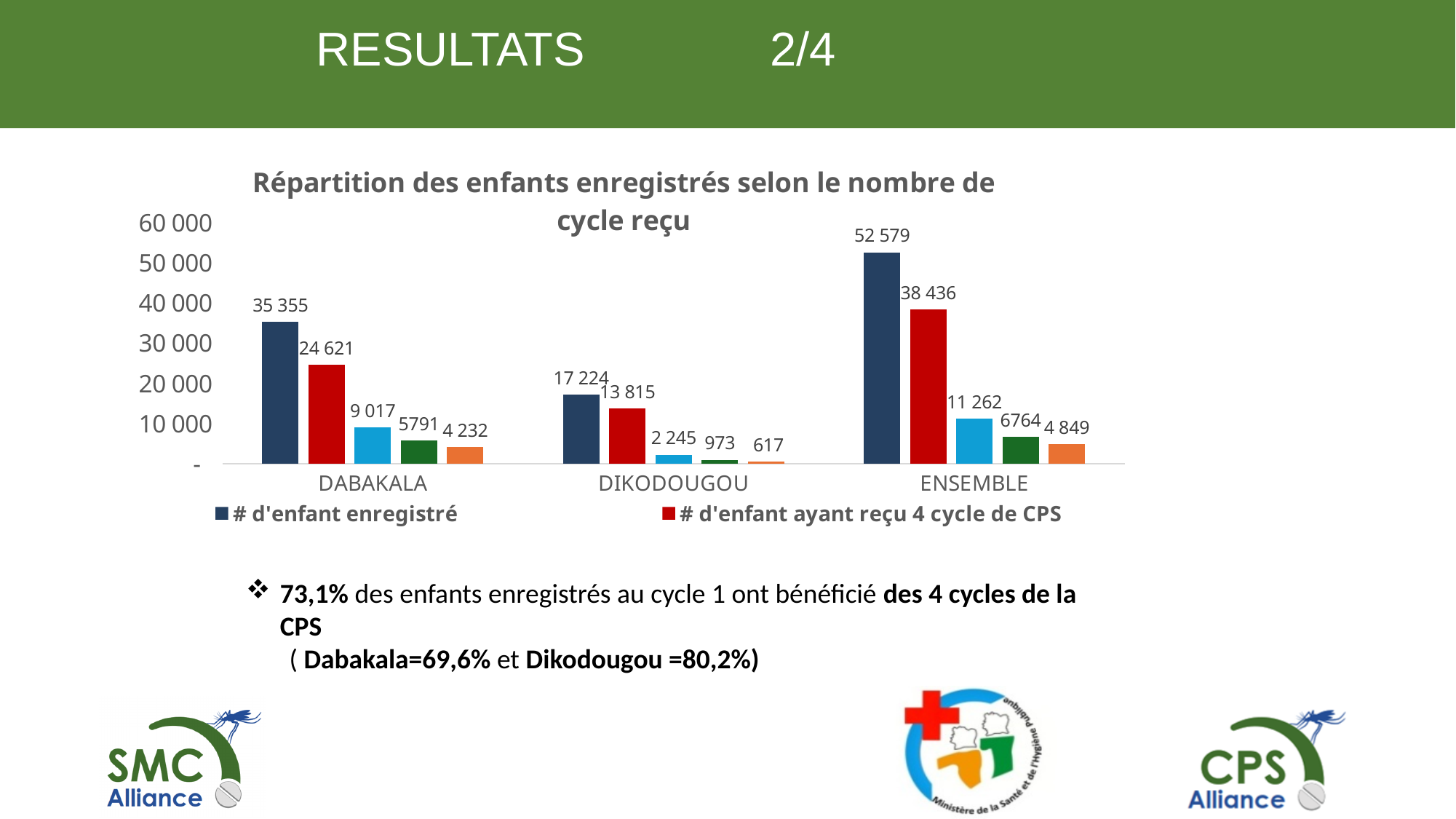
What is the value of "# d'enfant enregistré" for DABAKALA? 35 355 Is the value of "# d'enfant enregistré" for DIKODOUGOU greater or less than 20 000? less Which category has the highest value for "# d'enfant enregistré"? ENSEMBLE What kind of chart is shown on the slide? bar chart What is the value of "# d'enfant ayant reçu 4 cycle de CPS" for ENSEMBLE? 38 436 Which is larger: "# d'enfant enregistré" for DABAKALA or for DIKODOUGOU? DABAKALA Which category has the lowest value for "# d'enfant ayant reçu 4 cycle de CPS"? DIKODOUGOU For DABAKALA, what is the difference between "# d'enfant enregistré" and "# d'enfant ayant reçu 4 cycle de CPS"? 10 734 What is the title of the chart? Répartition des enfants enregistrés selon le nombre de cycle reçu What is the value of "# d'enfant ayant reçu 4 cycle de CPS" for DIKODOUGOU? 13 815 What is the value of "# d'enfant enregistré" for ENSEMBLE? 52 579 How many categories are shown on the x axis of the chart? 3